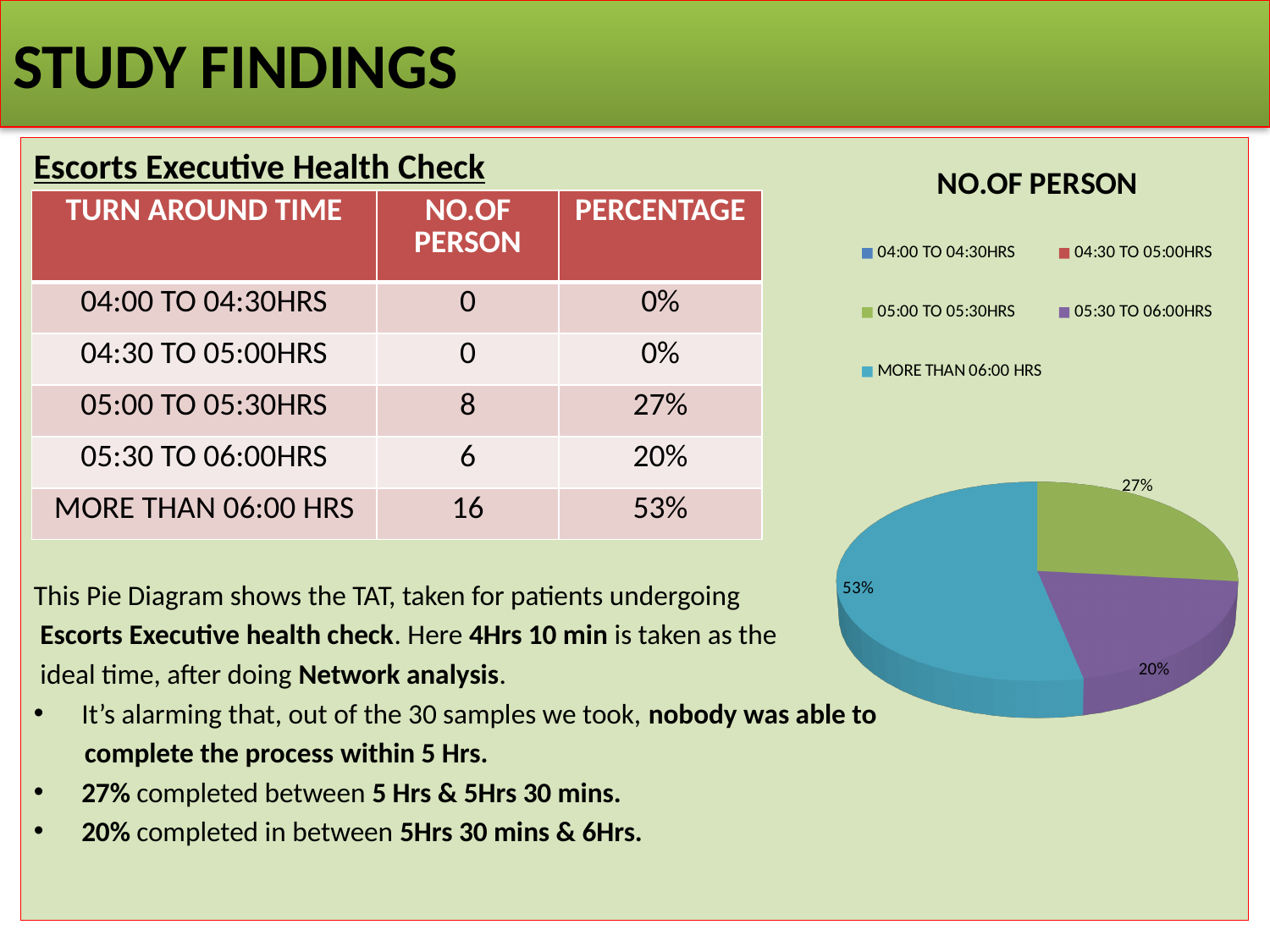
What colour is the MORE THAN 06:00 HRS slice in the pie chart? Blue What share of the pie does the MORE THAN 06:00 HRS slice represent? 53% Which category has the largest slice in the pie chart? MORE THAN 06:00 HRS What share of the pie does the 05:00 TO 05:30HRS slice represent? 27% What is the difference in percentage points between the 05:00 TO 05:30HRS slice and the 05:30 TO 06:00HRS slice? 7% How many entries does the pie chart's legend list? 5 Which of the visible slices is the smallest in the pie chart? 05:30 TO 06:00HRS What share of the pie does the 05:30 TO 06:00HRS slice represent? 20% What is the title of the pie chart? NO.OF PERSON Which slice is larger: 05:00 TO 05:30HRS or 05:30 TO 06:00HRS? 05:00 TO 05:30HRS What kind of chart is shown on the slide? Pie chart What is the difference in percentage points between the MORE THAN 06:00 HRS slice and the 05:00 TO 05:30HRS slice? 26%